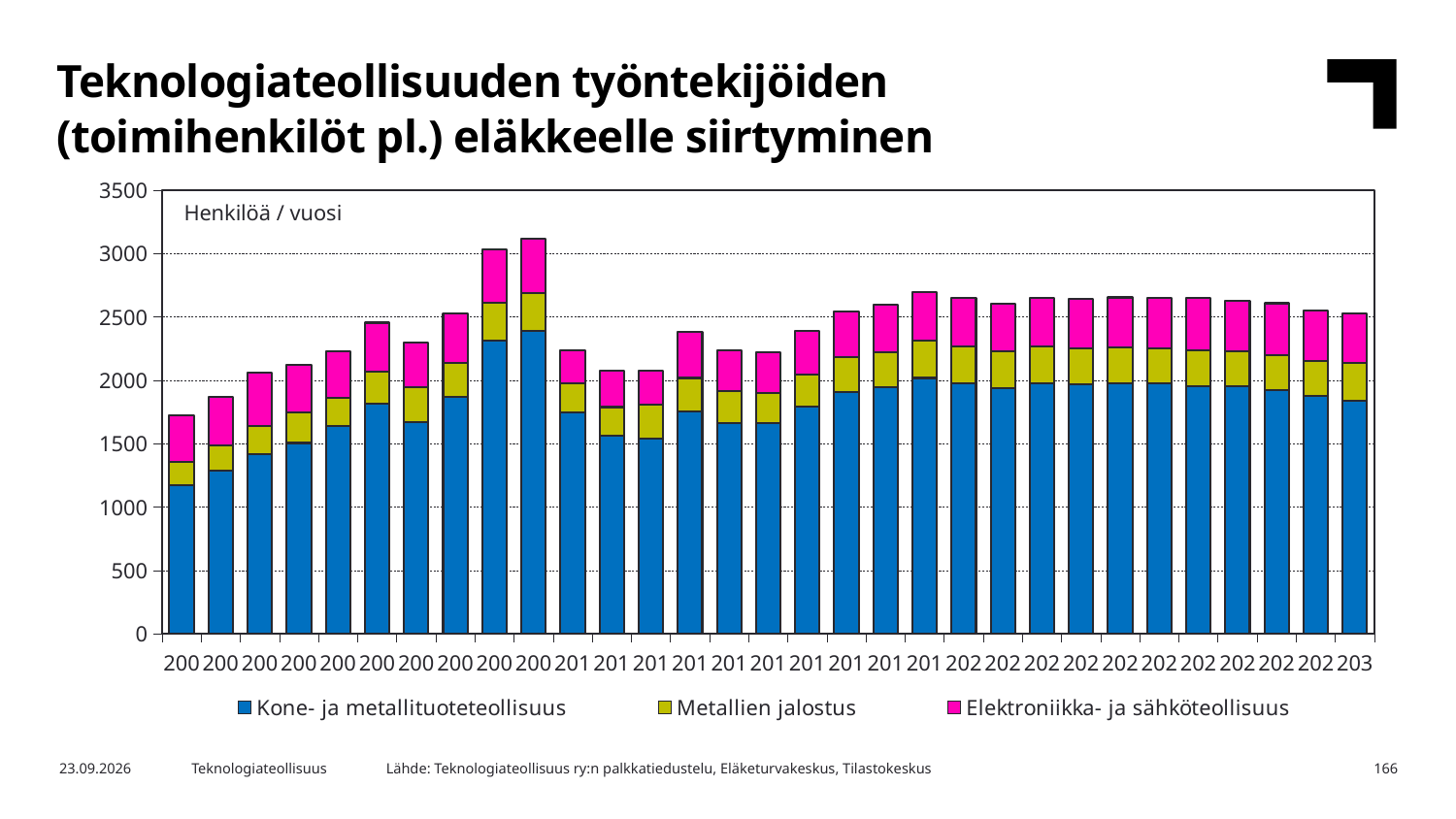
Which series contributes the largest segment in every bar? Kone- ja metallituoteteollisuus Which has the larger total, the leftmost bar or the rightmost bar? The rightmost bar What kind of chart is shown on the slide? Stacked bar chart Is the total of the rightmost bar greater or less than 2000? greater Is the total of the tallest bar greater or less than 3000? greater How many stacked bars are plotted in the chart? 31 Which series forms the bottom segment of each stacked bar? Kone- ja metallituoteteollisuus How many series does the legend list? 3 Is the total of the leftmost bar greater or less than 2000? less What are the three series named in the legend? Kone- ja metallituoteteollisuus, Metallien jalostus, Elektroniikka- ja sähköteollisuus